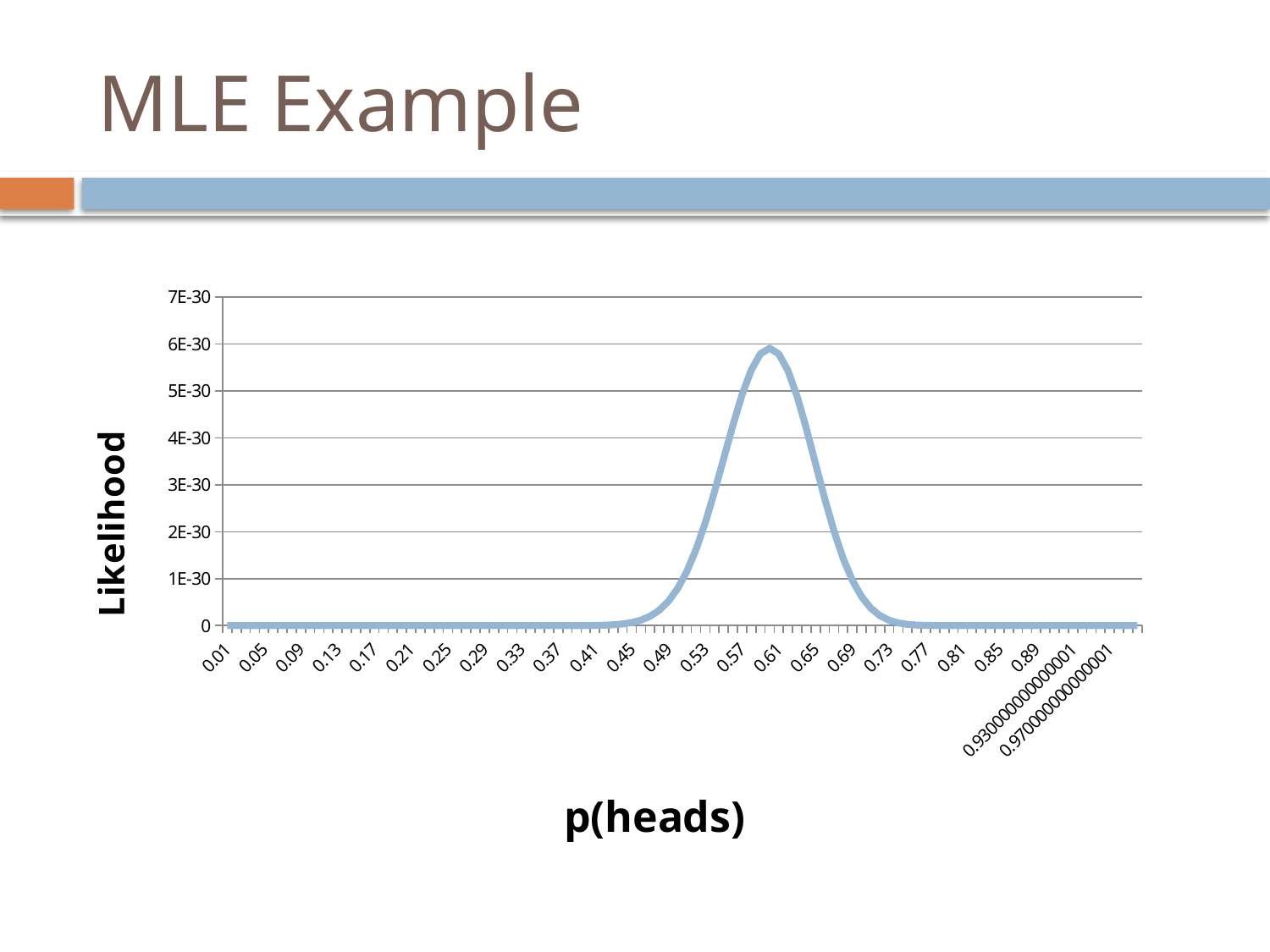
Is the likelihood at p(heads) = 0.65 greater or less than 3E-30? greater Is the likelihood at p(heads) = 0.61 greater or less than 5E-30? greater Is the likelihood at p(heads) = 0.53 greater or less than 1E-30? greater What is the title of the vertical axis? Likelihood At which value of p(heads) does the likelihood reach its highest point? 0.61 Which has the larger likelihood, p(heads) = 0.53 or p(heads) = 0.61? 0.61 Does the likelihood rise or fall as p(heads) goes from 0.45 to 0.61? rise What is the title of the horizontal axis? p(heads) Does the likelihood rise or fall as p(heads) goes from 0.61 to 0.77? fall What kind of chart is shown on the slide? line chart